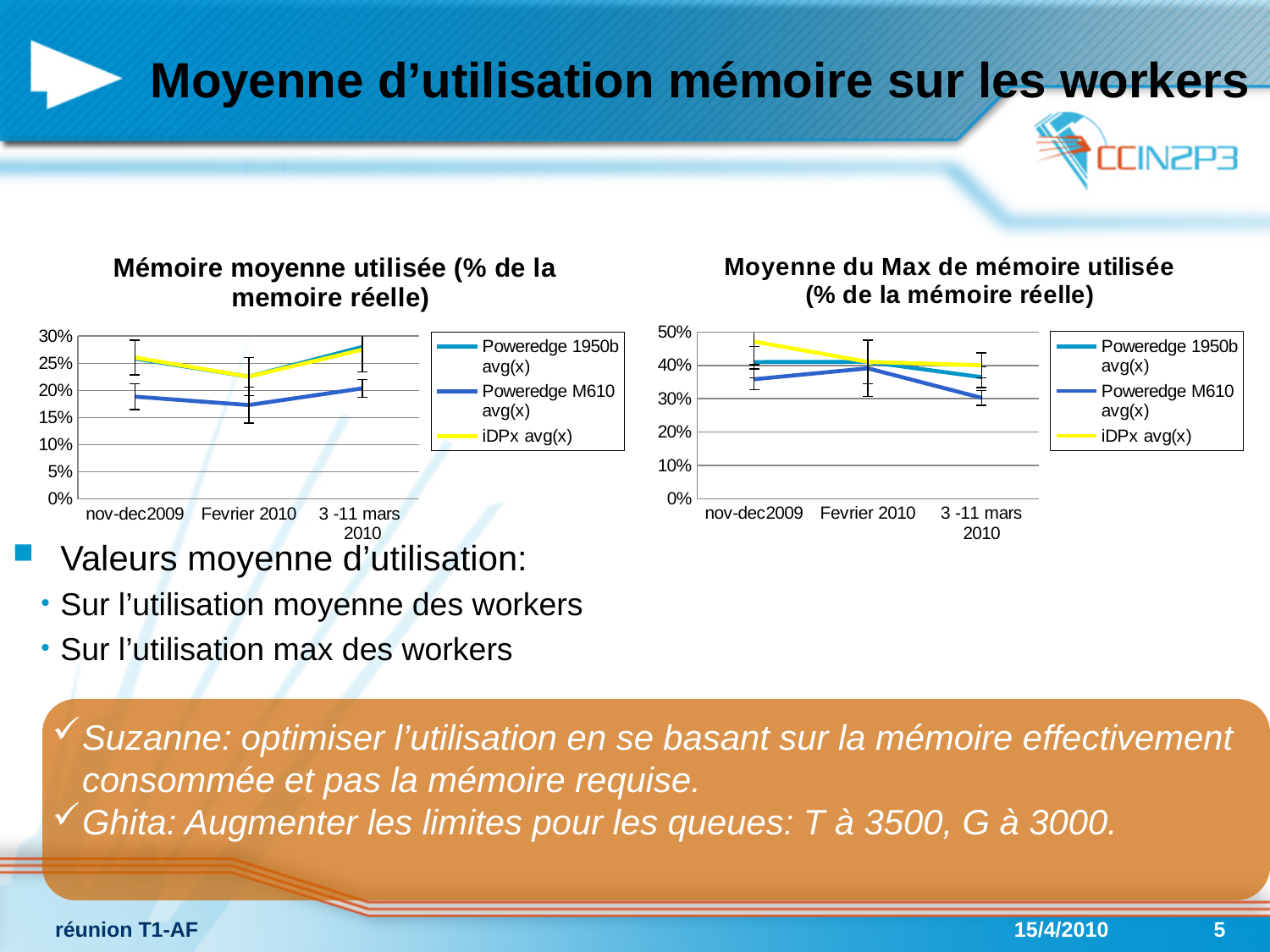
In the right chart "Moyenne du Max de mémoire utilisée", which series has the highest value at nov-dec2009? iDPx avg(x) In the right chart "Moyenne du Max de mémoire utilisée", is the value for Poweredge M610 avg(x) at 3-11 mars 2010 greater or less than 40%? less In the right chart "Moyenne du Max de mémoire utilisée", is the value for iDPx avg(x) at nov-dec2009 greater or less than 40%? greater How many series does the legend of the right chart "Moyenne du Max de mémoire utilisée" list? 3 In the left chart "Mémoire moyenne utilisée", is the value for Poweredge M610 avg(x) at Fevrier 2010 greater or less than 20%? less In the left chart "Mémoire moyenne utilisée", which series has the lowest values across all three periods? Poweredge M610 avg(x) How many time periods are shown on the x axis of the left chart "Mémoire moyenne utilisée"? 3 In the right chart "Moyenne du Max de mémoire utilisée", which is larger at 3-11 mars 2010: Poweredge 1950b avg(x) or Poweredge M610 avg(x)? Poweredge 1950b avg(x) What kind of chart is the left chart titled "Mémoire moyenne utilisée (% de la memoire réelle)"? line chart What is the title of the right chart? Moyenne du Max de mémoire utilisée (% de la mémoire réelle) In the right chart "Moyenne du Max de mémoire utilisée", does the iDPx avg(x) series rise or fall from nov-dec2009 to 3-11 mars 2010? fall